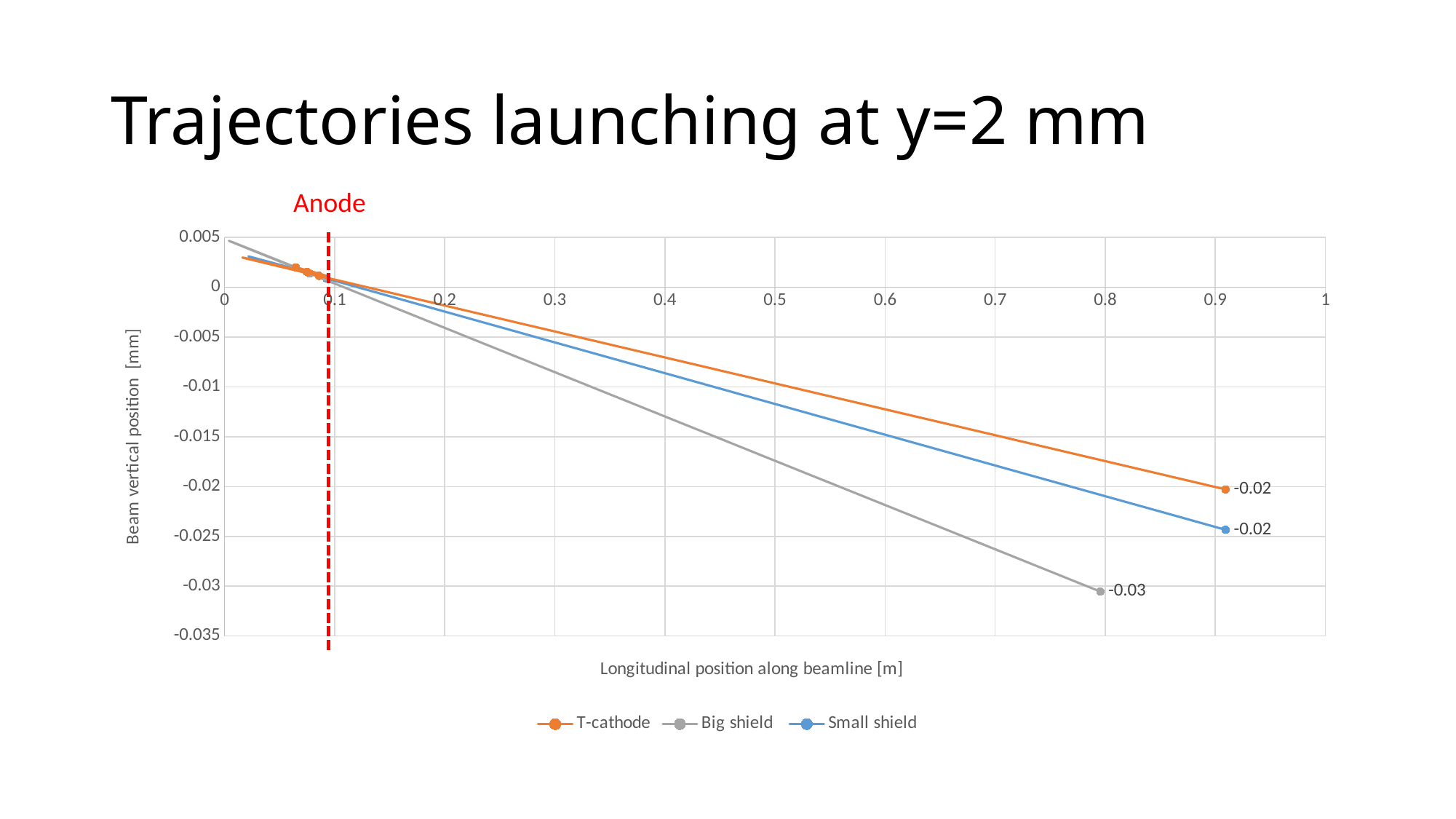
Which series ends at the lowest beam vertical position? Big shield What kind of chart is shown on the slide? line chart How many series does the legend list? 3 Do the beam vertical positions rise or fall as the longitudinal position increases? fall What is the data label at the end of the T-cathode line? -0.02 Is the value for Big shield at a longitudinal position of 0.5 m greater or less than -0.01? less What is the data label at the end of the Big shield line? -0.03 What is the data label at the end of the Small shield line? -0.02 At a longitudinal position of 0.9 m, which series has the higher beam vertical position, T-cathode or Small shield? T-cathode What does the red dashed vertical line on the chart mark? Anode Is the value for Small shield at a longitudinal position of 0.9 m greater or less than -0.02? less Which series ends at the highest beam vertical position at the right end of the chart? T-cathode